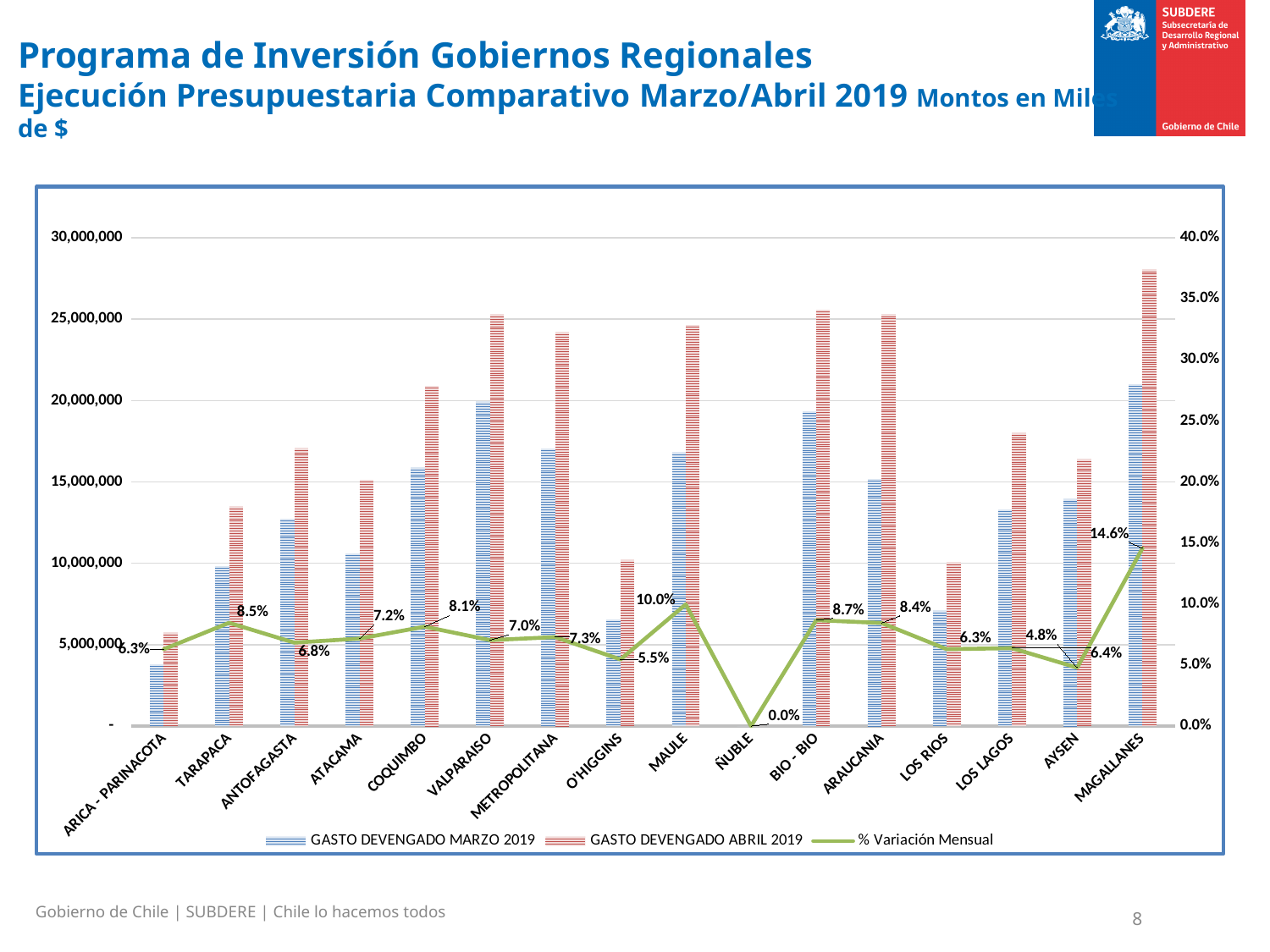
Which region has the highest % Variación Mensual? MAGALLANES Is the GASTO DEVENGADO ABRIL 2019 value for MAGALLANES greater or less than 25,000,000? greater Which region has the lowest % Variación Mensual? ÑUBLE What is the % Variación Mensual value for MAULE? 10.0% Which has a higher % Variación Mensual, TARAPACA or ATACAMA? TARAPACA How many regions are shown on the x axis of the chart? 16 What is the % Variación Mensual value for MAGALLANES? 14.6% Is the GASTO DEVENGADO MARZO 2019 value for ARICA - PARINACOTA greater or less than 5,000,000? less What kind of chart is shown on the slide? Combination bar and line chart What is the % Variación Mensual value for ÑUBLE? 0.0% What is the difference between the % Variación Mensual of MAGALLANES and MAULE? 4.6% How many series does the chart legend list? 3